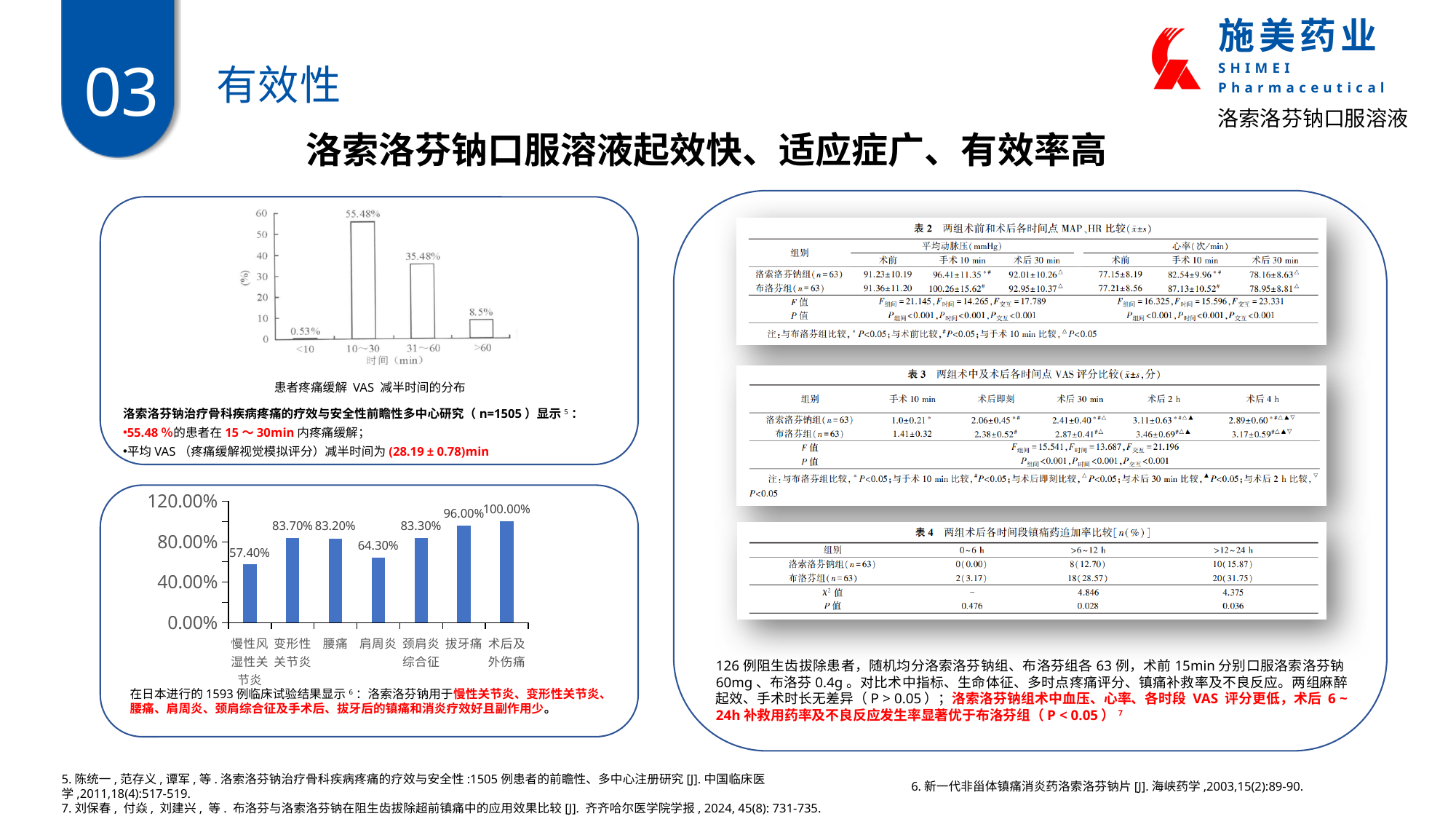
In the bottom-left bar chart, which category has the lowest value? 慢性风湿性关节炎 In the top-left chart (患者疼痛缓解 VAS 减半时间的分布), what is the difference between the 10~30 and 31~60 categories? 20 percentage points In the top-left chart (患者疼痛缓解 VAS 减半时间的分布), which time category has the lowest value? <10 In the bottom-left bar chart, which is larger, the value for 变形性关节炎 or the value for 肩周炎? 变形性关节炎 In the top-left chart (患者疼痛缓解 VAS 减半时间的分布), what is the value for the >60 min category? 8.5% In the bottom-left bar chart, how many categories are shown on the x axis? 7 In the top-left chart (患者疼痛缓解 VAS 减半时间的分布), what is the value for the 10~30 min category? 55.48% In the bottom-left bar chart, which category has the highest value? 术后及外伤痛 In the bottom-left bar chart, what is the value for 拔牙痛? 96.00% In the top-left chart (患者疼痛缓解 VAS 减半时间的分布), how many time categories are shown on the x axis? 4 What type of chart is the top-left chart (患者疼痛缓解 VAS 减半时间的分布)? Bar chart In the bottom-left bar chart, what is the value for 肩周炎? 64.30%